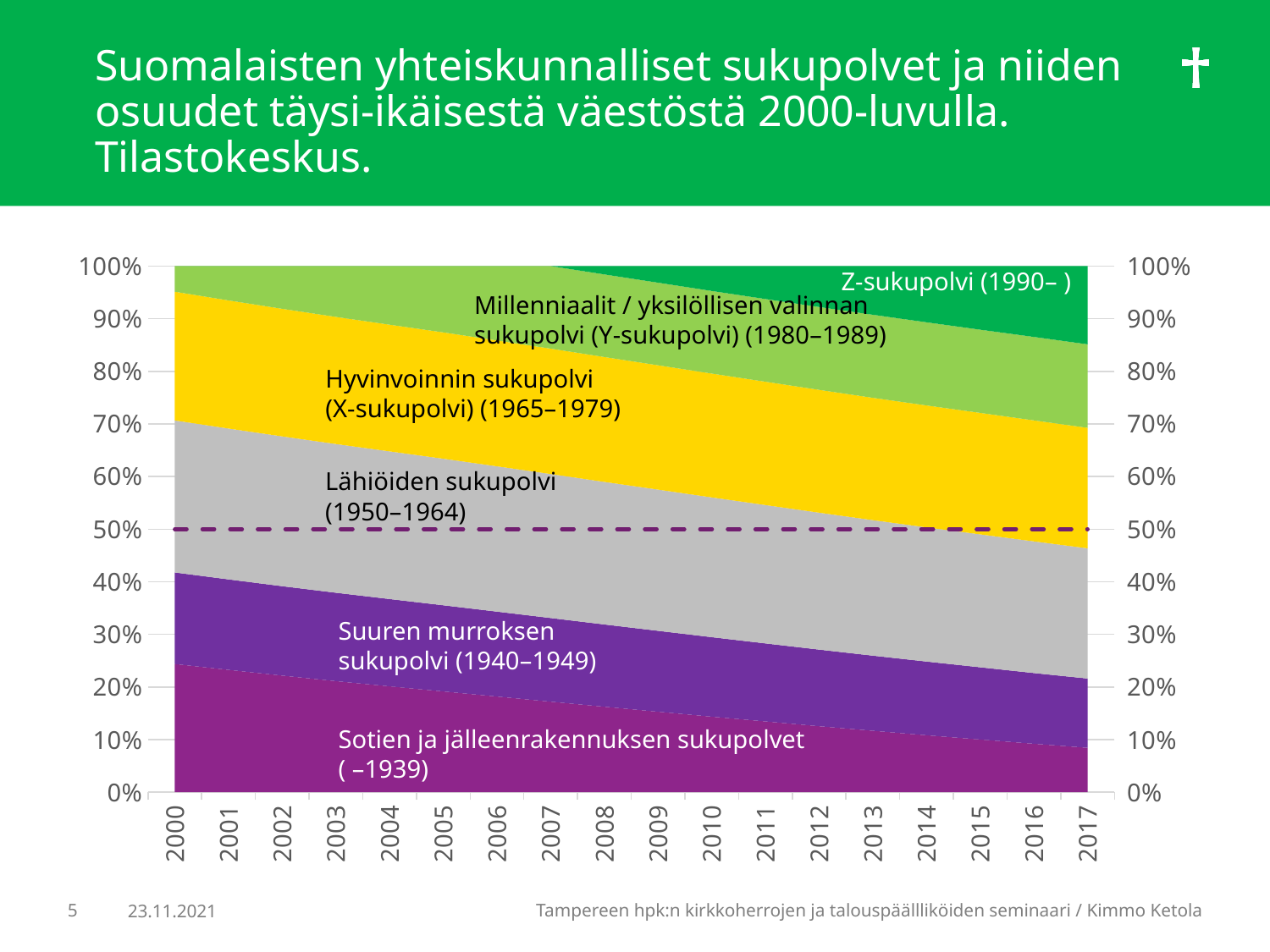
At what percentage level is the horizontal dashed line drawn in the chart? 50% What kind of chart is shown on the slide? stacked area chart How many generations (series) are labelled in the chart? 6 Which generation is shown at the bottom of the stacked area chart? Sotien ja jälleenrakennuksen sukupolvet ( –1939) How many years are shown along the x axis of the chart? 18 Does the share of 'Sotien ja jälleenrakennuksen sukupolvet ( –1939)' rise or fall from 2000 to 2017? fall What is the last year shown on the x axis? 2017 What is the first year shown on the x axis? 2000 Is the share of 'Sotien ja jälleenrakennuksen sukupolvet ( –1939)' in 2000 greater or less than 20%? greater What is the highest value shown on the y axis of the chart? 100% Does the share of 'Z-sukupolvi (1990– )' rise or fall over the years shown? rise Is the share of 'Sotien ja jälleenrakennuksen sukupolvet ( –1939)' in 2017 greater or less than 10%? less